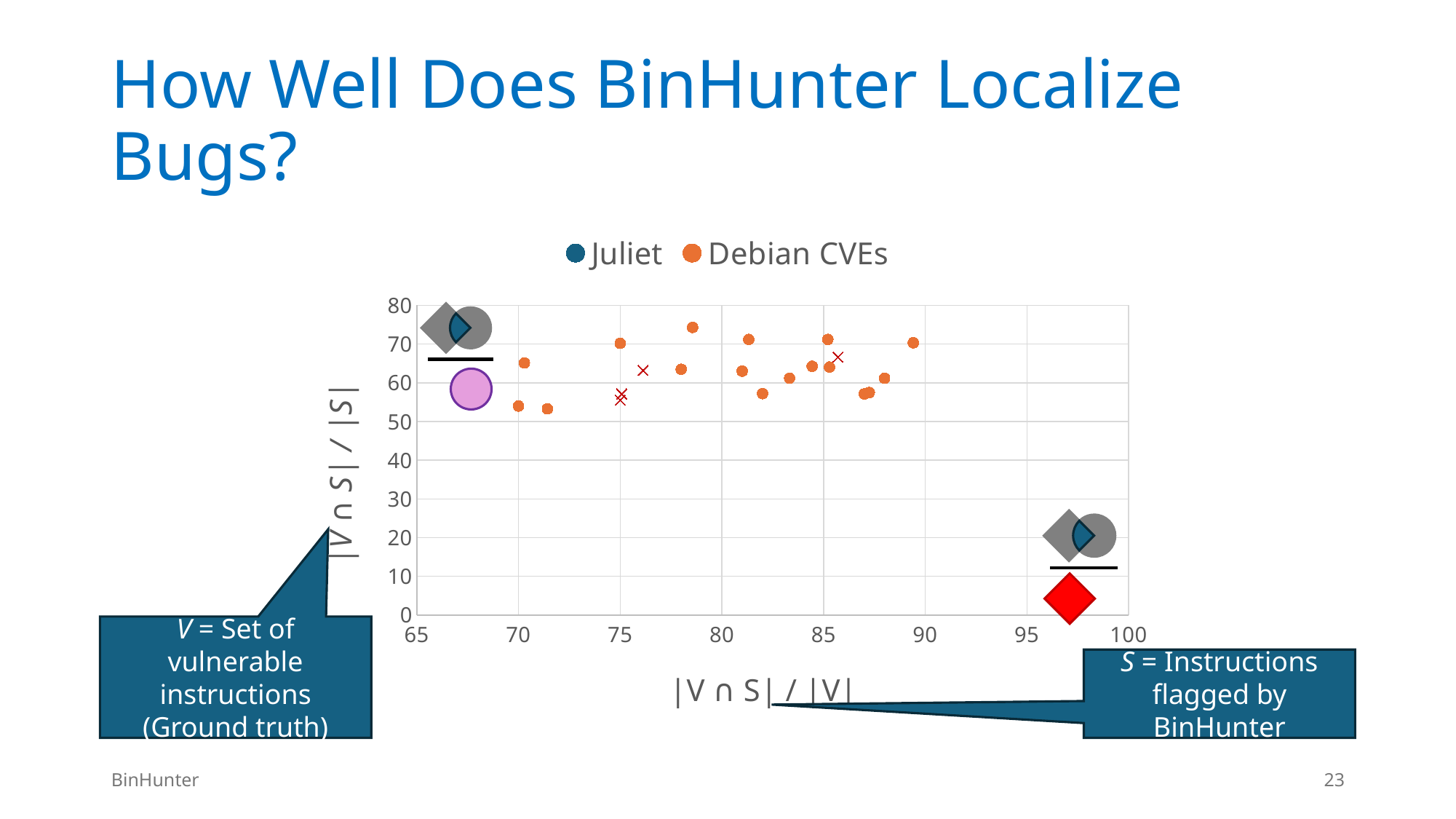
Is the lowest y value of any plotted point greater or less than 40? greater What kind of chart is shown on the slide? scatter chart Is the y value of the lowest Debian CVEs point greater or less than 50? greater What are the two series named in the chart legend? Juliet and Debian CVEs Is the x value of the rightmost Debian CVEs point greater or less than 95? less How many series does the chart legend list? 2 What is the label of the chart's x axis? |V ∩ S| / |V|